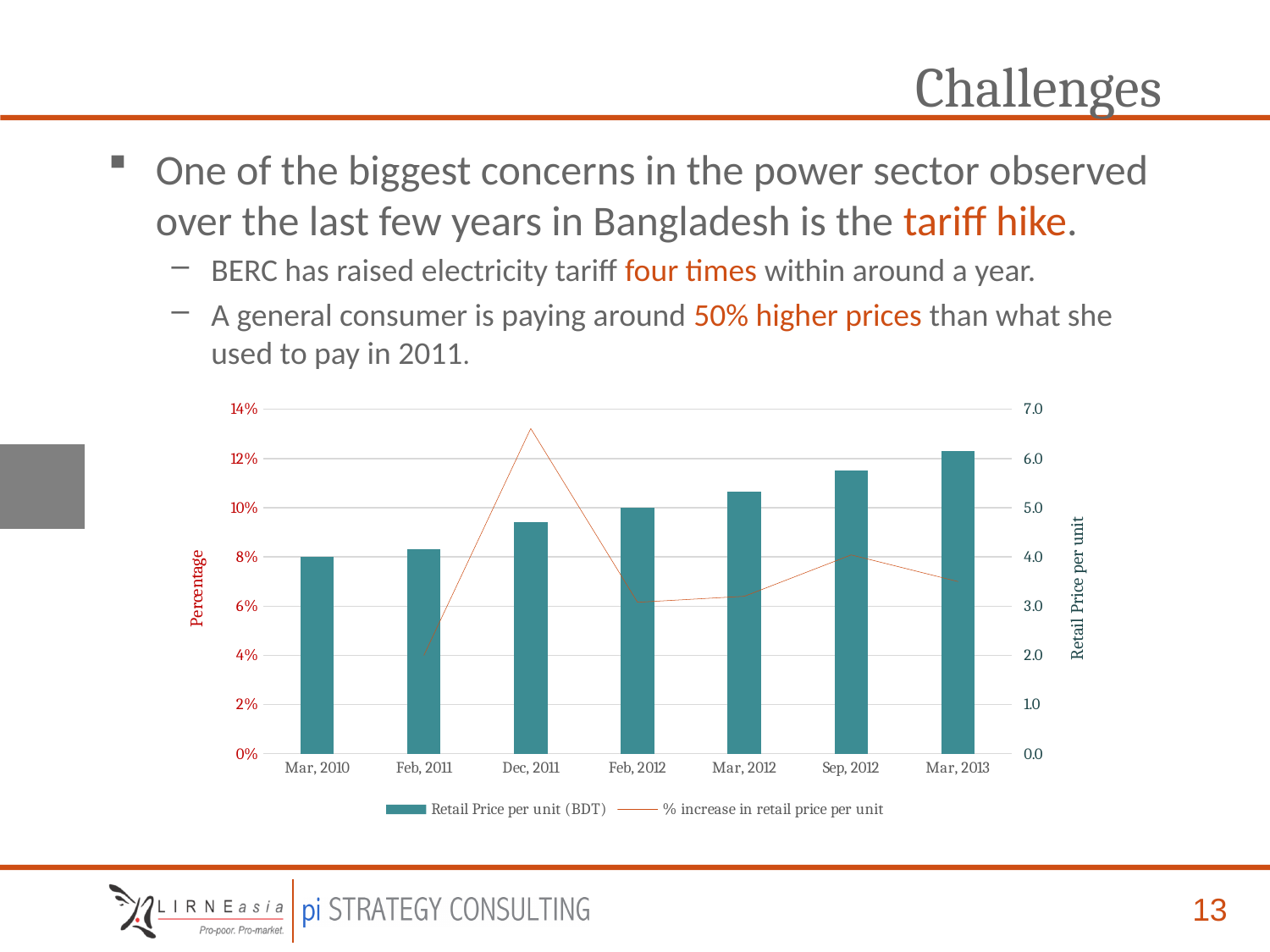
How many time periods are shown on the x axis of the chart? 7 Which period has the highest bar for Retail Price per unit (BDT)? Mar, 2013 Is the % increase in retail price per unit for Feb, 2011 greater or less than 6%? less Which has the larger Retail Price per unit (BDT) bar, Mar, 2012 or Sep, 2012? Sep, 2012 Is the % increase in retail price per unit for Dec, 2011 greater or less than 12%? greater What is the title of the left vertical axis of the chart? Percentage How many series does the chart legend list? 2 Which period has the lowest bar for Retail Price per unit (BDT)? Mar, 2010 Is the Retail Price per unit (BDT) bar for Sep, 2012 greater or less than 6.0? less Do the Retail Price per unit (BDT) bars rise or fall from Mar, 2010 to Mar, 2013? Rise What kind of chart is shown on the slide? A combination bar and line chart In which period does the % increase in retail price per unit line reach its peak? Dec, 2011